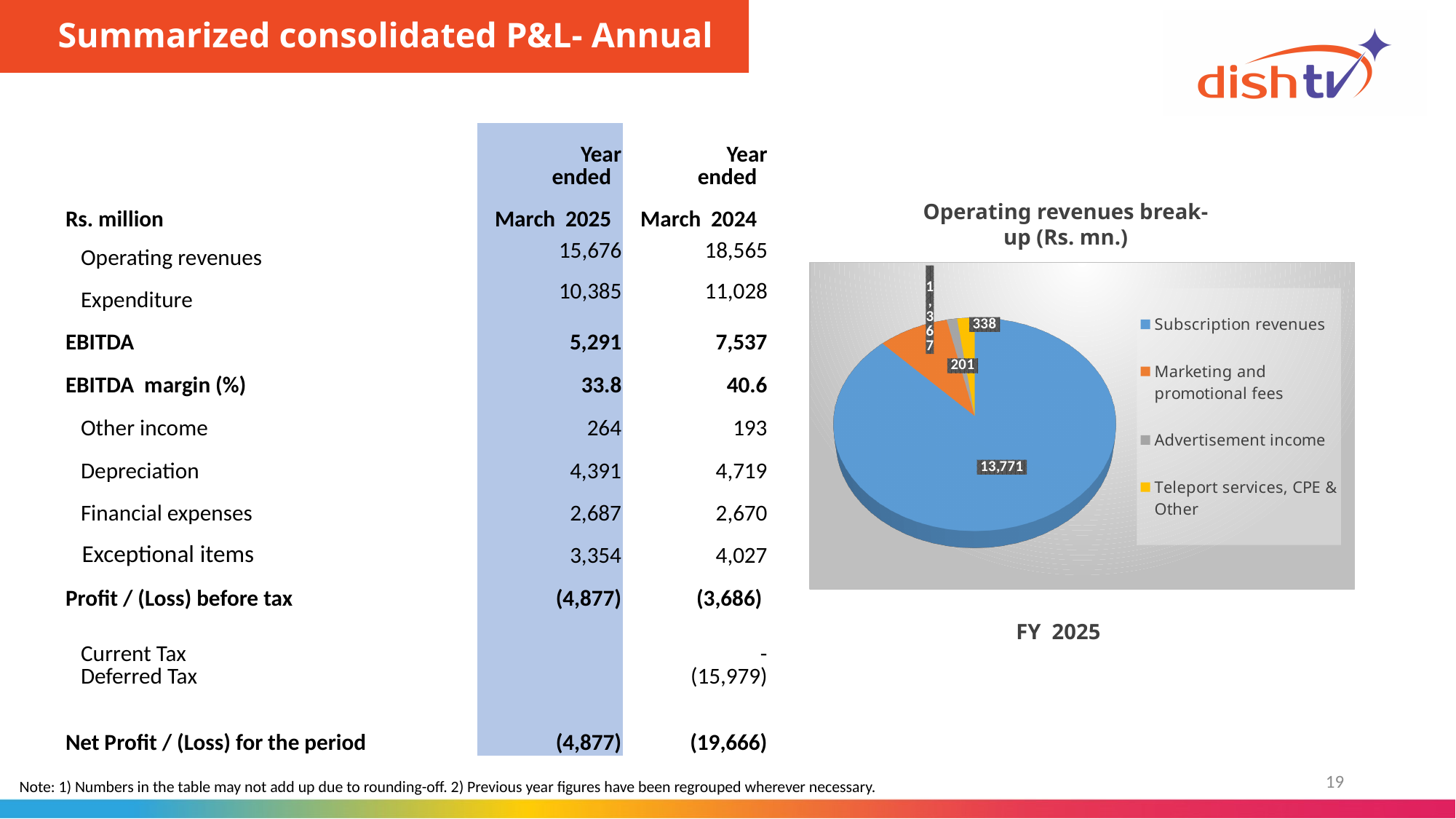
What is the value for Teleport services, CPE & Other in the pie chart? 338 What is the title of the pie chart? Operating revenues break-up (Rs. mn.) Which category has the smallest slice in the pie chart? Advertisement income What type of chart is shown on the slide? Pie chart Which category has the largest slice in the Operating revenues break-up pie chart? Subscription revenues What is the difference between Marketing and promotional fees and Teleport services, CPE & Other in the pie chart? 1,029 What is the value for Advertisement income in the pie chart? 201 Which is larger in the pie chart: Teleport services, CPE & Other or Advertisement income? Teleport services, CPE & Other What is the value for Marketing and promotional fees in the pie chart? 1,367 What is the value for Subscription revenues in the Operating revenues break-up pie chart? 13,771 What colour is the Subscription revenues slice in the pie chart? Blue How many slices does the pie chart have? 4